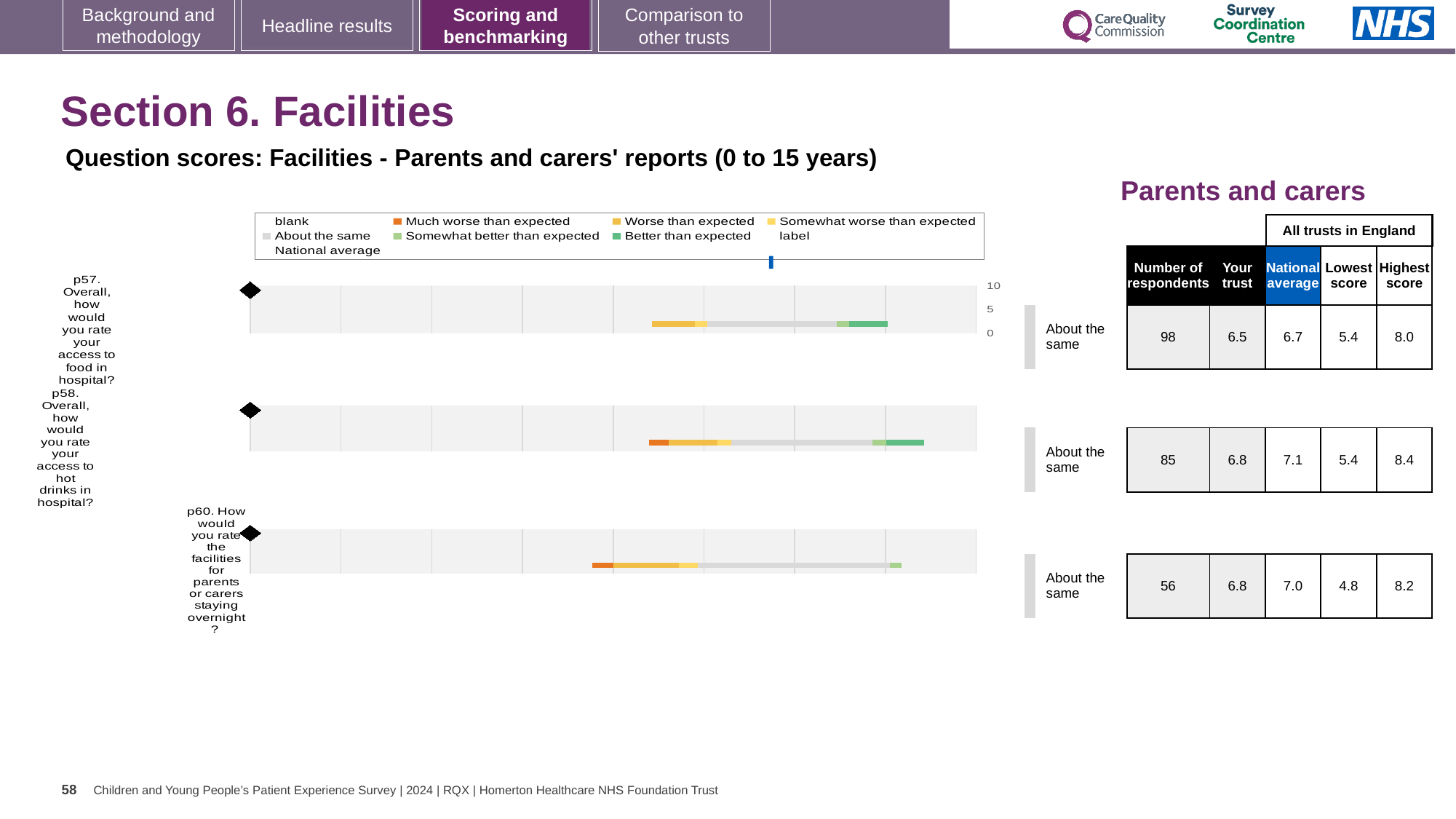
For the p57 chart (access to food in hospital), how many respondents are listed in the table? 98 What benchmark category is shown next to each of the three charts? About the same What kind of chart is used to show the p57 question score? bar chart Which of the three questions has the highest 'Highest score' across all trusts in England? p58 For the p60 chart, how many respondents are listed? 56 For the p58 chart, is the 'Your trust' score higher or lower than the national average? lower How many question charts are shown on the slide? 3 For the p60 chart (facilities for parents or carers staying overnight), what is the national average score? 7.0 Which of the three questions has the lowest 'Lowest score' across all trusts in England? p60 For the p58 chart (access to hot drinks in hospital), what is the 'Your trust' score? 6.8 What is the highest tick value shown on the score axis of the charts? 10 For the p57 chart, what is the difference between the national average and the 'Your trust' score? 0.2